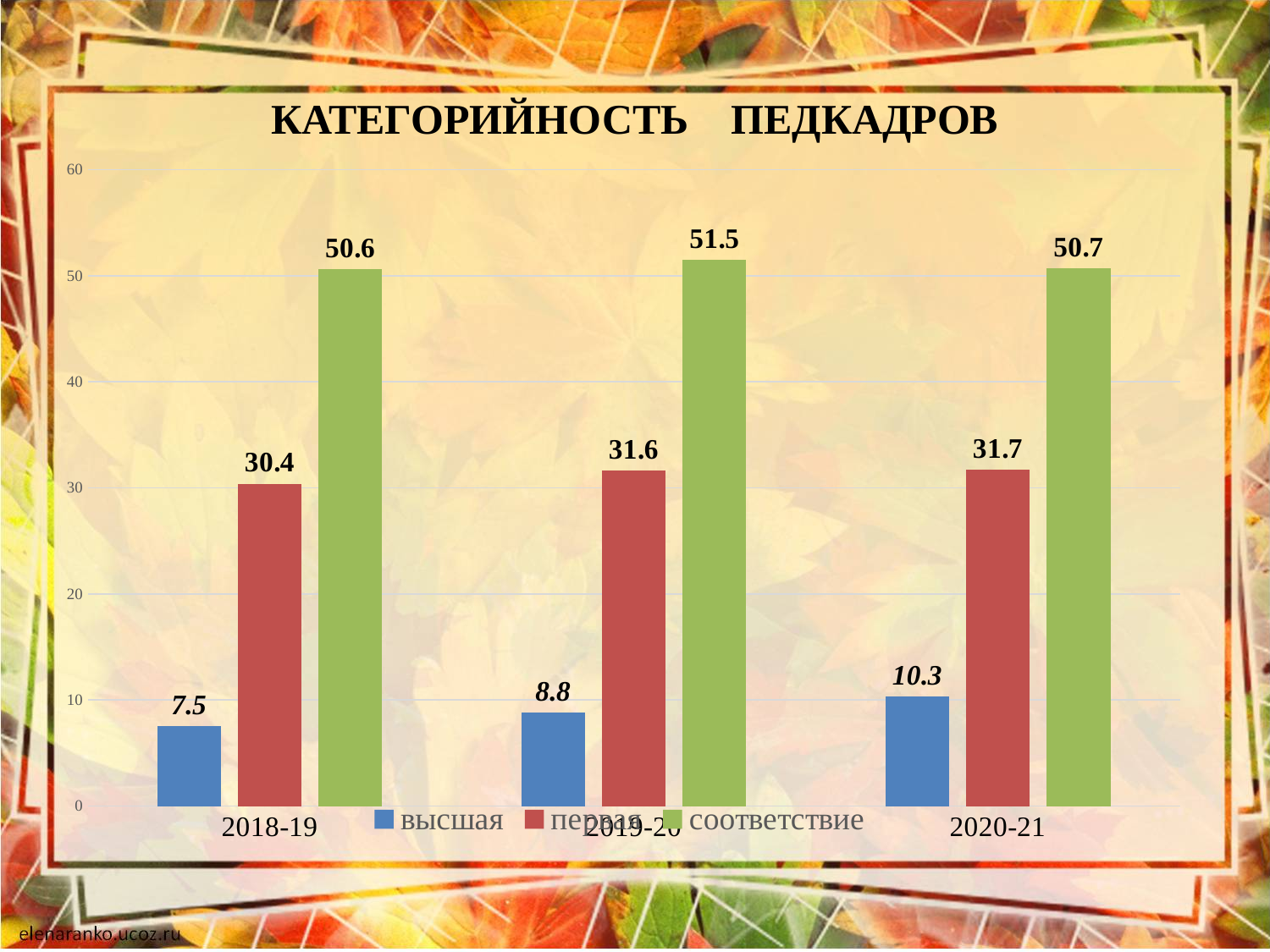
Does the value for высшая rise or fall from 2018-19 to 2020-21? rise In which year is the value for высшая the highest? 2020-21 What kind of chart is shown on the slide? bar chart How many year categories are shown on the x axis? 3 In which year is the value for высшая the lowest? 2018-19 Is the value for соответствие in 2020-21 greater or less than 50? greater What is the difference between the соответствие value and the первая value in 2018-19? 20.2 How many series does the legend list? 3 Which is larger in 2019-20: the value for первая or the value for высшая? первая What is the value for соответствие in 2019-20? 51.5 What is the value for первая in 2020-21? 31.7 What is the value for высшая in 2018-19? 7.5